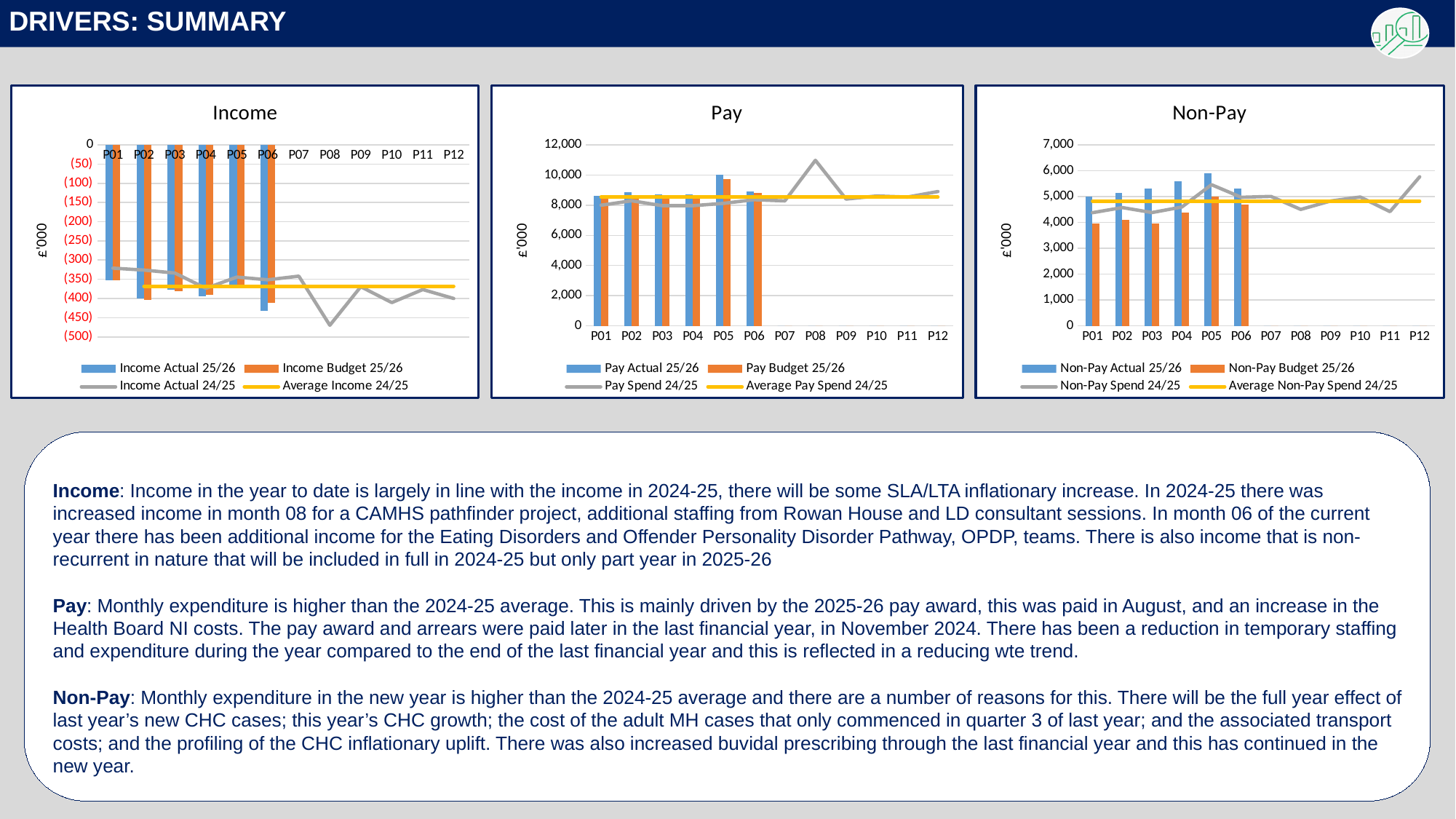
In the Pay chart, which period has the highest Pay Actual 25/26 bar? P05 In the Pay chart, how many series does the legend list? 4 In the Pay chart, how many periods have bars plotted? 6 In the Pay chart, is the Pay Actual 25/26 value for P05 greater or less than 8,000? greater In the Non-Pay chart, how many periods are shown on the x axis? 12 What kind of chart is the Income chart? bar and line chart In the Pay chart, at which period does the Pay Spend 24/25 line reach its highest point? P08 In the Pay chart, is the Pay Budget 25/26 value for P01 greater or less than 10,000? less In the Non-Pay chart, is the Non-Pay Actual 25/26 value for P05 greater or less than 5,000? greater In the Income chart, which period has the lowest (most negative) Income Actual 25/26 bar? P06 What is the y-axis label on the Income chart? £'000